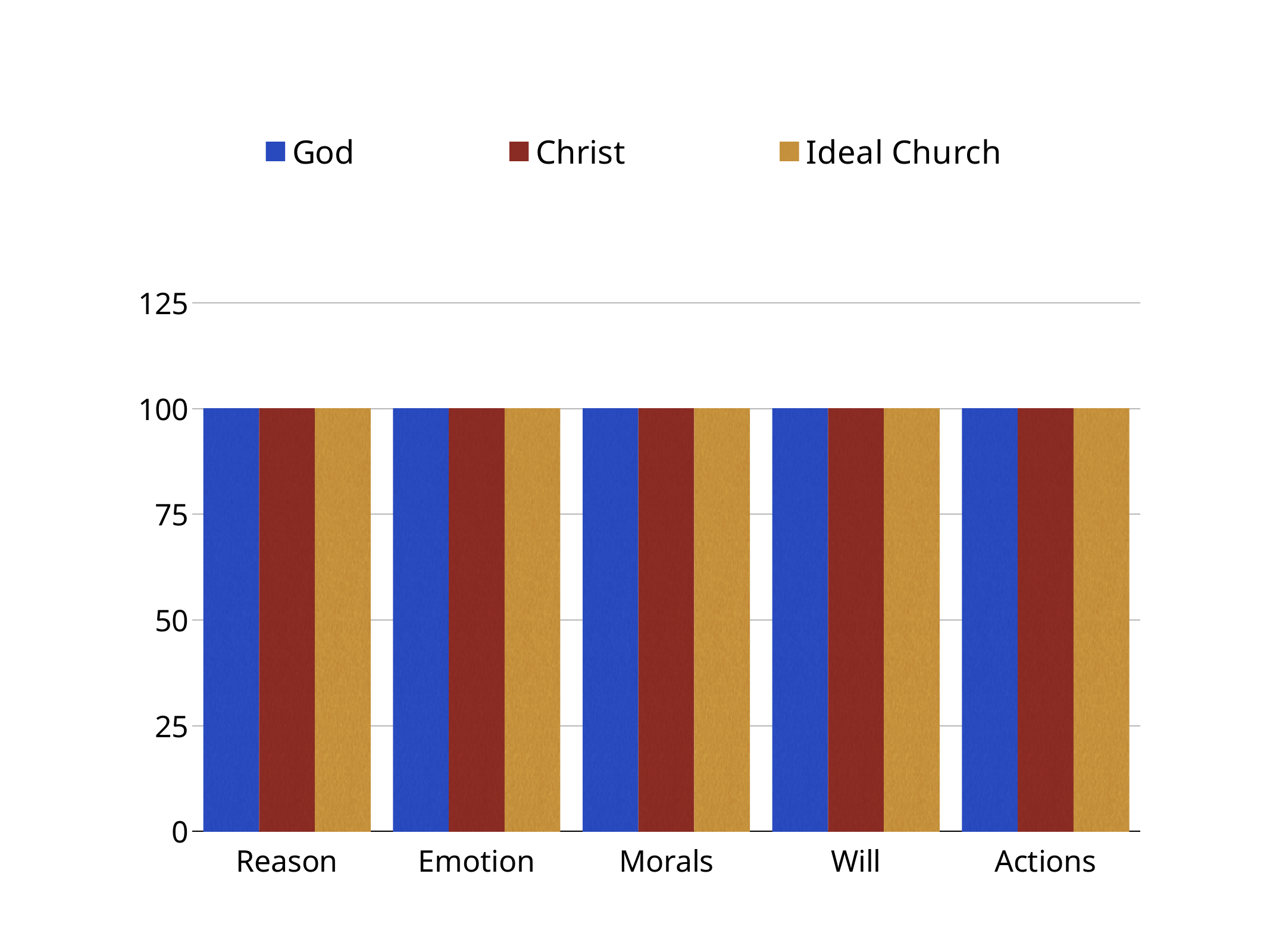
How many series does the legend list? 3 What are the three series listed in the legend? God, Christ, Ideal Church What is the value for Christ in the Morals category? 100 What kind of chart is shown on the slide? bar chart What is the difference between the God value and the Christ value in the Emotion category? 0 Which series is shown in blue? God Do the values for the God series rise, fall, or stay the same across the categories from Reason to Actions? stay the same Is the value for God in the Will category greater or less than 75? greater What is the value for Ideal Church in the Actions category? 100 How many categories are shown on the x axis? 5 Is the value for Ideal Church in the Emotion category greater or less than 125? less What is the value for God in the Reason category? 100